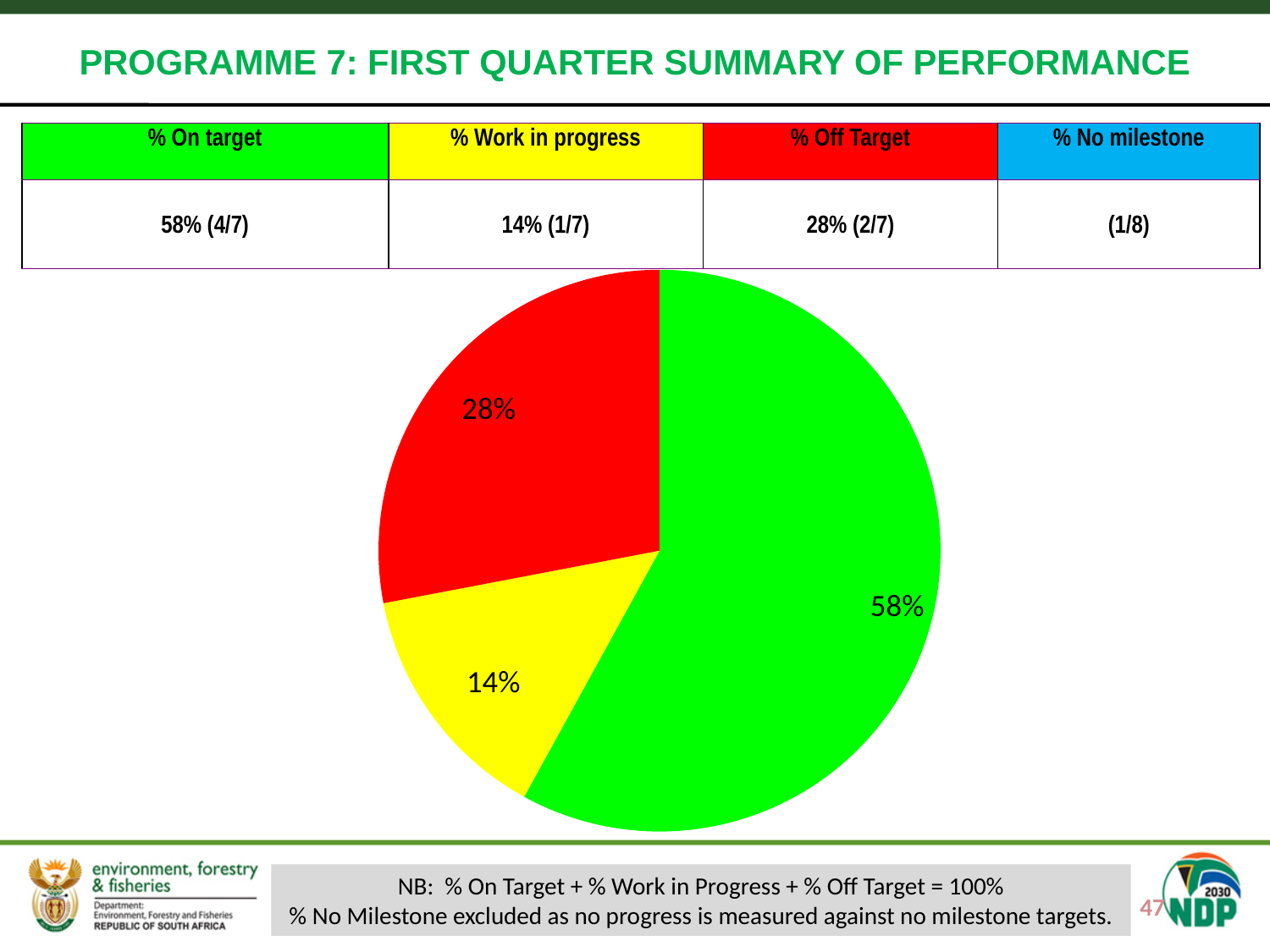
What percentage is shown on the yellow slice of the pie chart? 14% Which slice of the pie chart is the smallest? 14% (yellow, % Work in progress) What kind of chart is shown on the slide? Pie chart What is the difference between the green slice and the red slice of the pie chart? 30% How many slices does the pie chart have? 3 According to the table, which category does the green colour represent? % On target What percentage is shown on the red slice of the pie chart? 28% What percentage is shown on the green slice of the pie chart? 58% What is the combined share of the yellow and red slices in the pie chart? 42% According to the table, which category does the red colour represent? % Off Target Which slice of the pie chart is the largest? 58% (green, % On target) Which is larger in the pie chart, the red slice or the yellow slice? The red slice (28%)